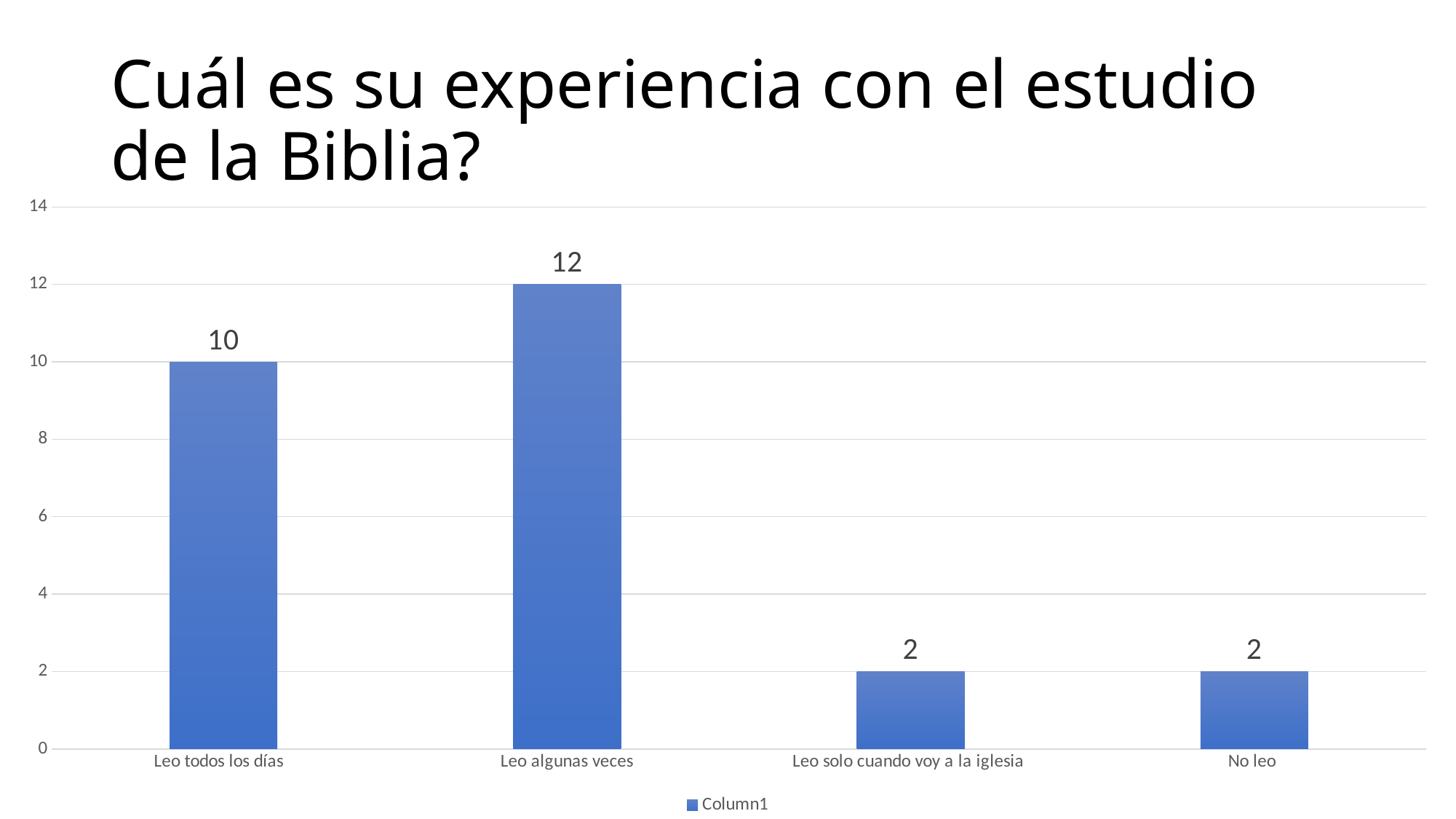
How many categories are shown on the x axis? 4 What is the difference between the values for "Leo todos los días" and "No leo"? 8 What is the value for "Leo todos los días"? 10 What is the difference between the values for "Leo algunas veces" and "Leo todos los días"? 2 What is the name of the series shown in the legend? Column1 What kind of chart is shown on the slide? Bar chart Which category has the highest value? Leo algunas veces How many series does the legend list? 1 Which is larger, the value for "Leo todos los días" or the value for "Leo solo cuando voy a la iglesia"? Leo todos los días What is the value for "Leo solo cuando voy a la iglesia"? 2 What is the value for "Leo algunas veces"? 12 What is the value for "No leo"? 2